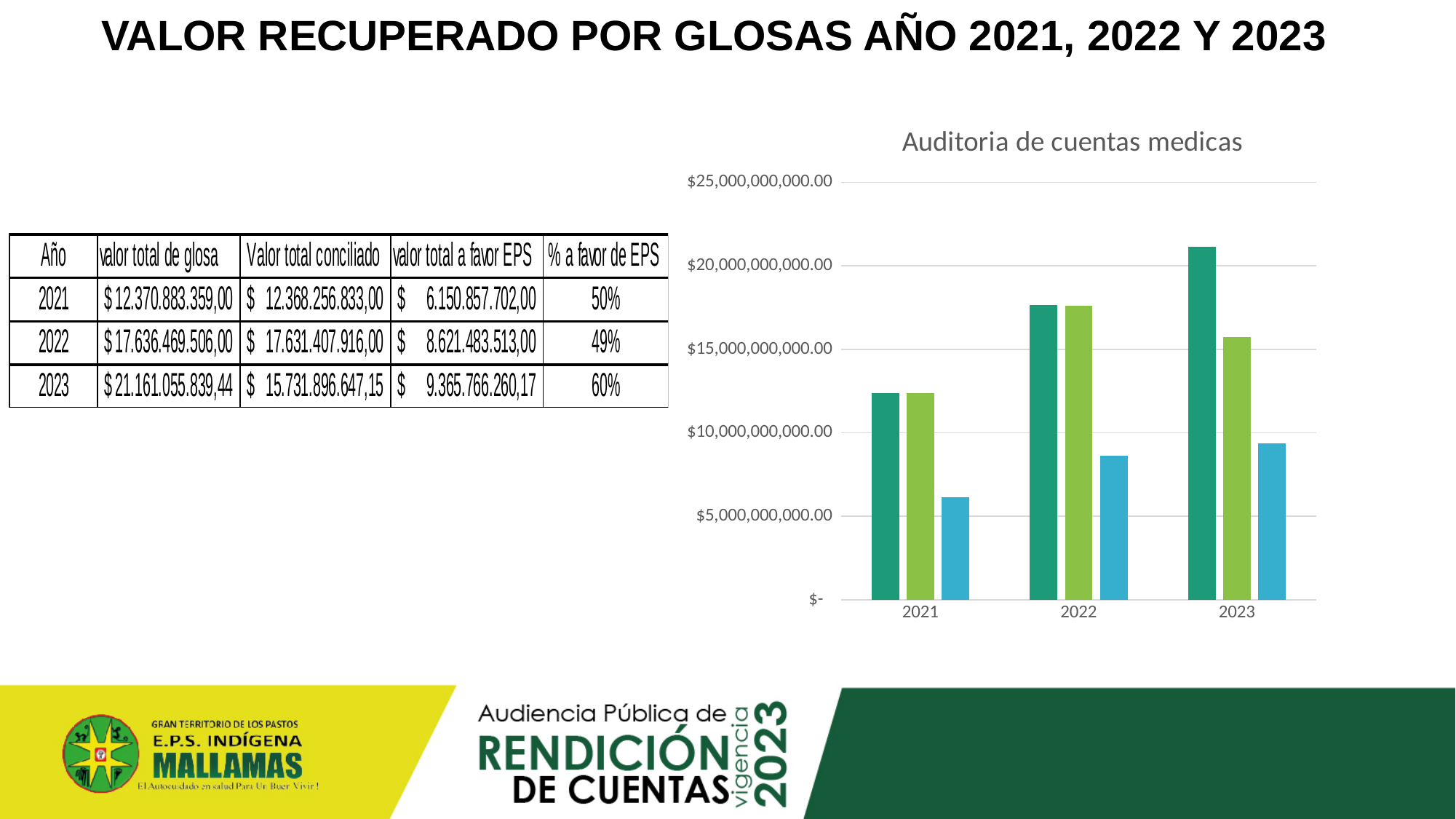
Do the dark green bars rise or fall from 2021 to 2023? rise For 2023, which is larger: the dark green bar or the light green bar? the dark green bar How many bars are plotted for each year in the chart? 3 Is the value of the blue bar for 2021 greater or less than $10,000,000,000.00? less What is the title of the chart? Auditoria de cuentas medicas Which year has the tallest bar in the chart? 2023 How many years are shown on the x axis of the chart? 3 Is the value of the light green bar for 2022 greater or less than $15,000,000,000.00? greater What kind of chart is shown on the slide? bar chart Which year has the shortest blue bar? 2021 Is the value of the dark green bar for 2023 greater or less than $20,000,000,000.00? greater